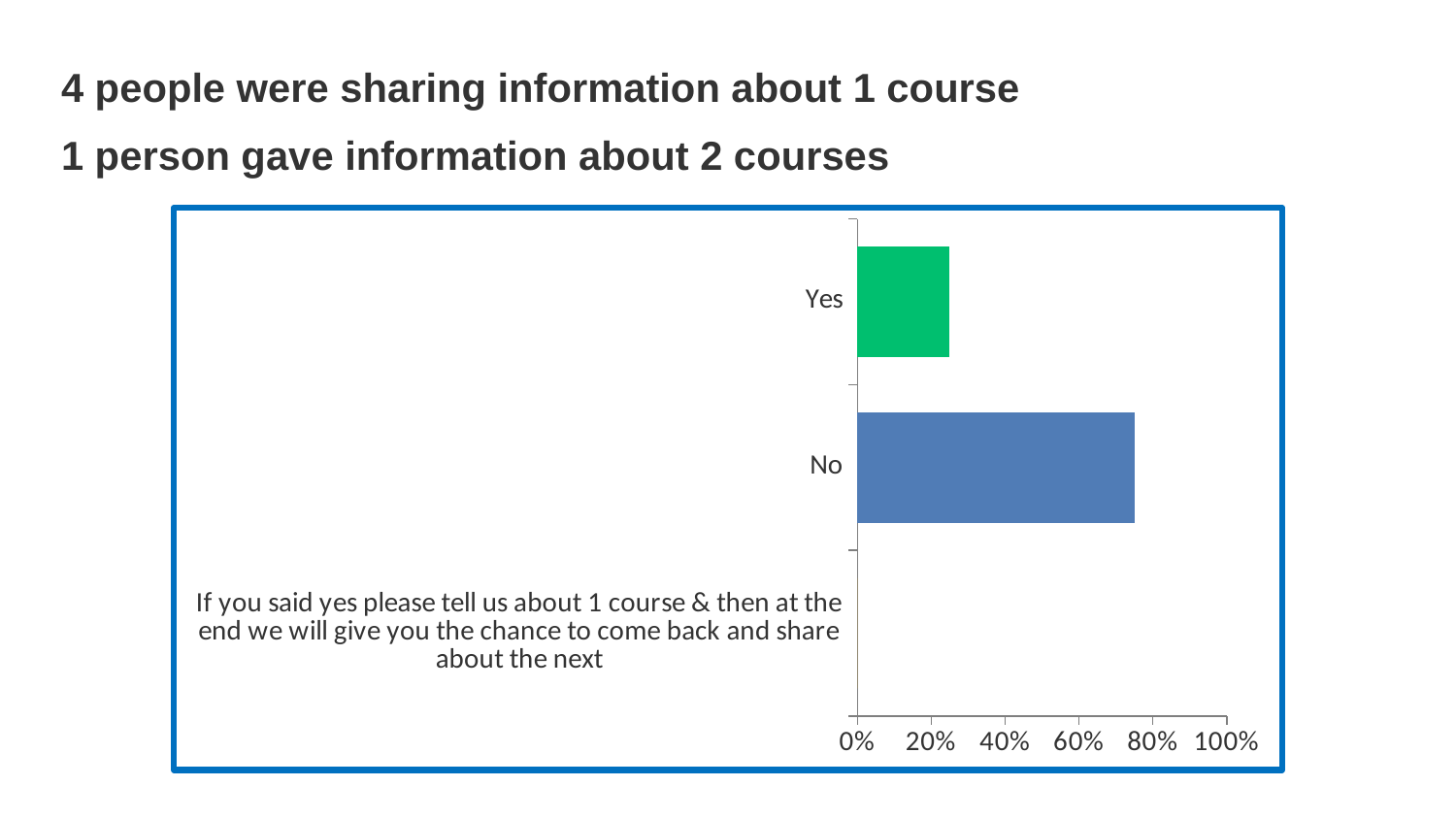
Is the value for Yes greater or less than 20%? greater What is the highest value shown on the horizontal axis? 100% Is the value for Yes greater or less than 40%? less Is the value for No greater or less than 60%? greater Which category has the longest bar? No How many category labels appear on the vertical axis of the chart? 3 What kind of chart is shown on the slide? bar chart What colour is the bar for Yes? green Which is larger, the value for Yes or the value for No? No Which of the plotted bars is the shortest? Yes How many bars are plotted in the chart? 2